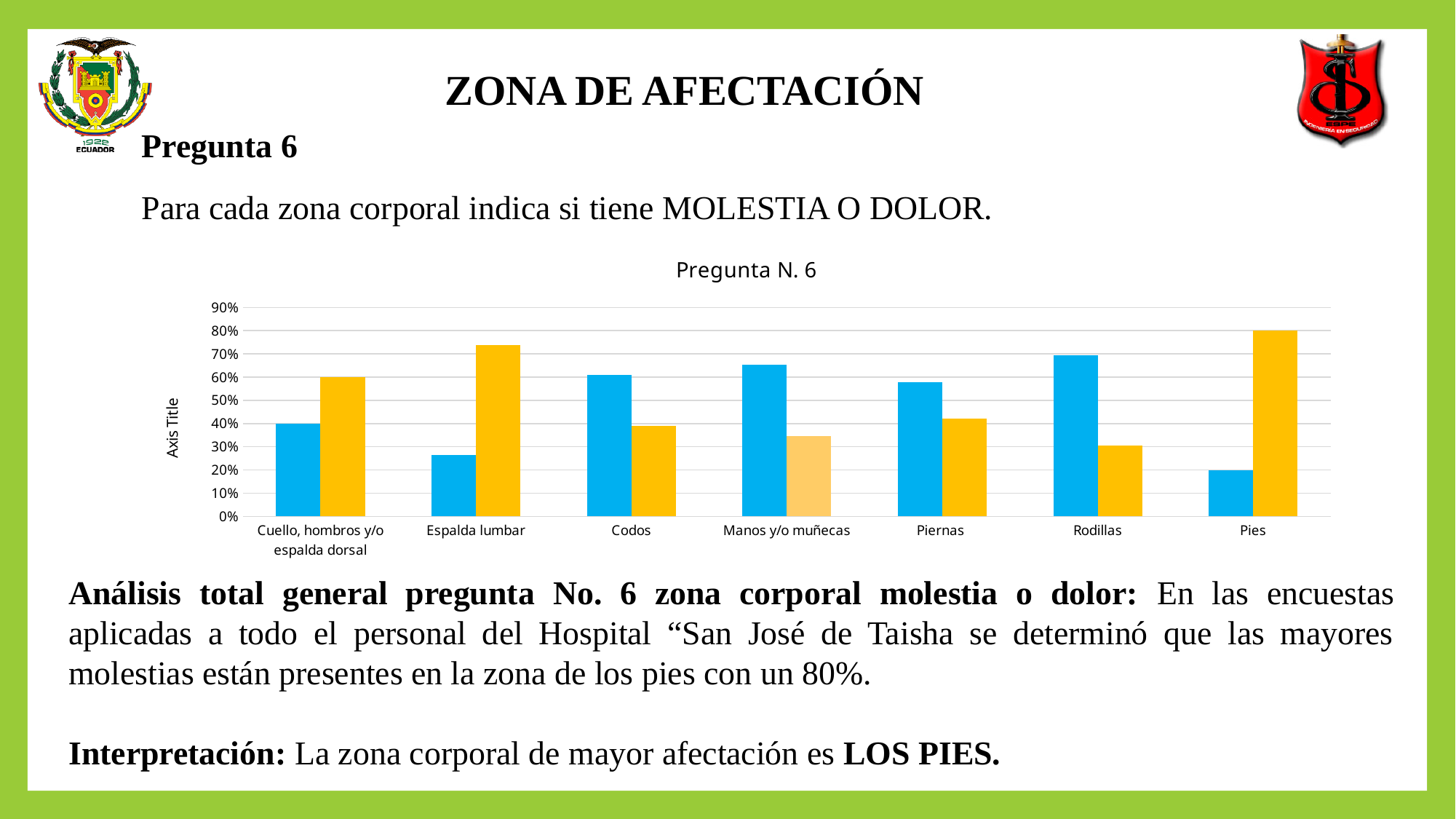
For Codos, which bar is taller, the blue bar or the yellow bar? the blue bar What is the value of the yellow bar for Pies? 80% Is the value of the blue bar for Espalda lumbar greater or less than 30%? less How many body-zone categories are shown on the x axis of the chart? 7 What is the title of the chart? Pregunta N. 6 How many bars are plotted for each category in the chart? 2 Is the value of the blue bar for Rodillas greater or less than 60%? greater Which category has the tallest yellow bar in the chart? Pies For Espalda lumbar, which bar is taller, the blue bar or the yellow bar? the yellow bar What kind of chart is shown on the slide? bar chart Which category has the shortest blue bar in the chart? Pies Which category has the shortest yellow bar in the chart? Rodillas